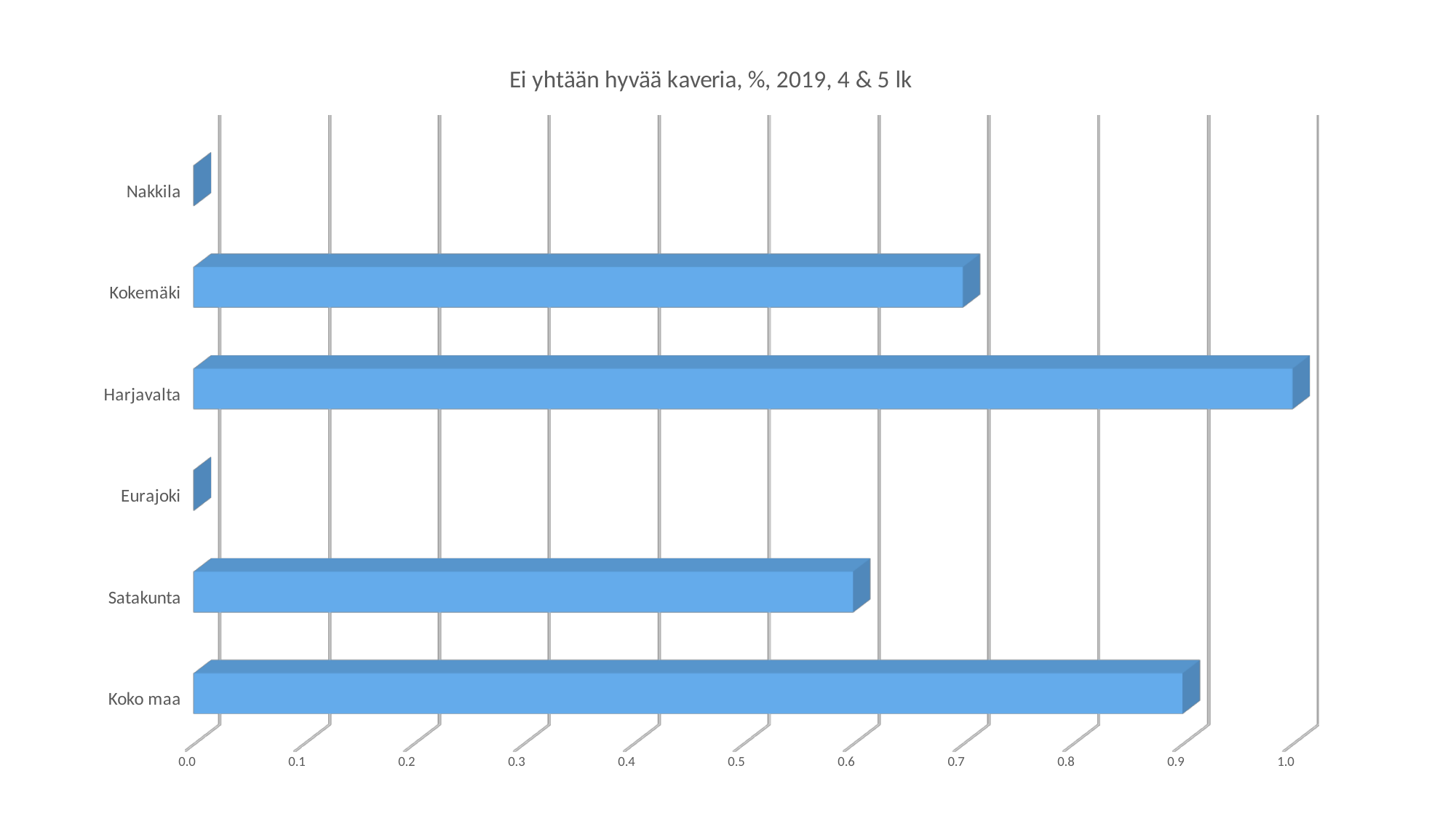
Is the value for Kokemäki greater or less than 0.9? less Is the value for Satakunta greater or less than 0.8? less What is the title of the chart? Ei yhtään hyvää kaveria, %, 2019, 4 & 5 lk Which is larger, the value for Koko maa or the value for Satakunta? Koko maa Is the value for Harjavalta greater or less than 0.9? greater How many categories are shown on the chart? 6 What type of chart is shown on the slide? bar chart Which is larger, the value for Harjavalta or the value for Kokemäki? Harjavalta Which is larger, the value for Kokemäki or the value for Satakunta? Kokemäki Which category has the highest value? Harjavalta